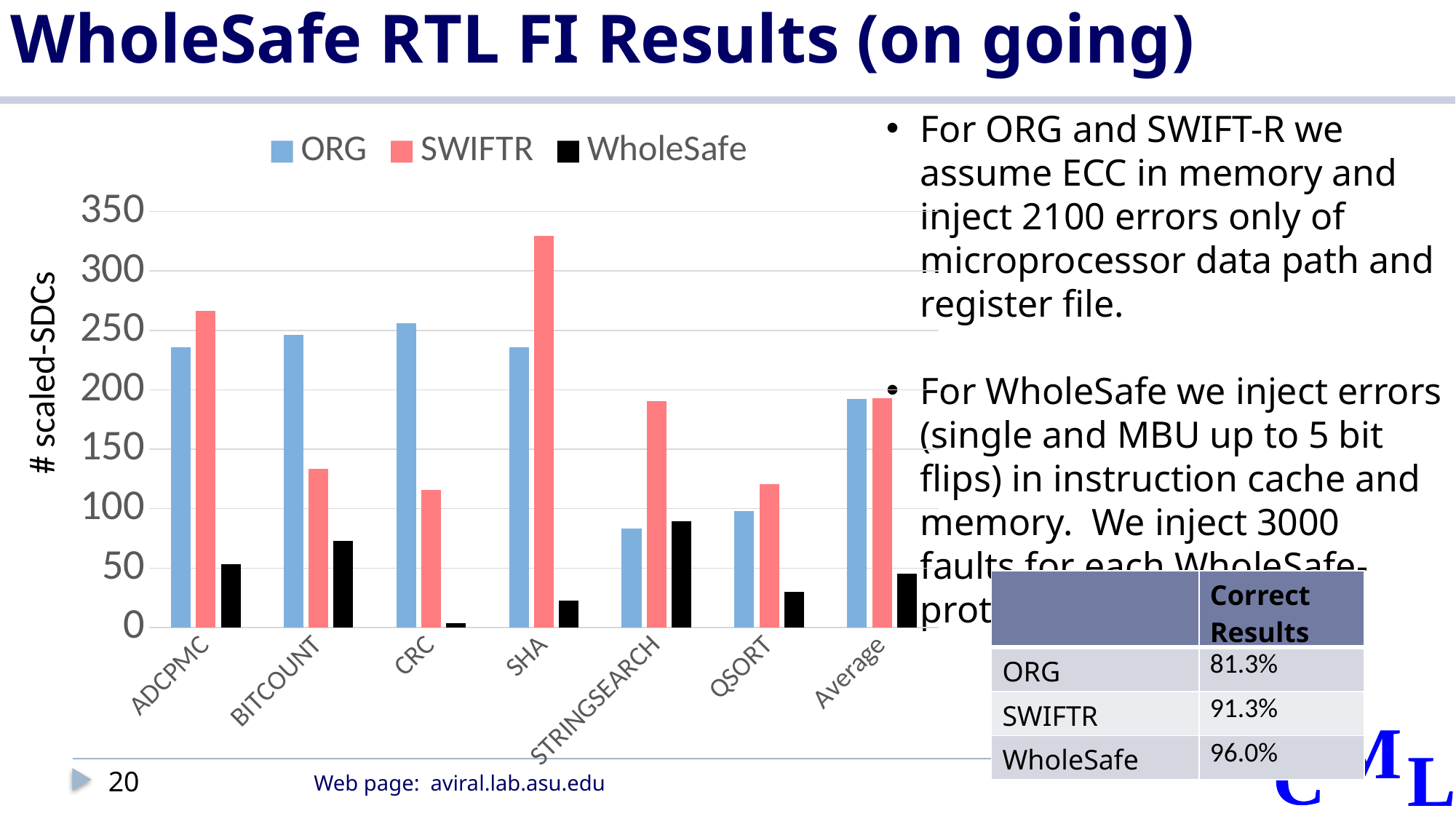
Is the ORG value for STRINGSEARCH greater or less than 100? less Is the SWIFTR value for STRINGSEARCH greater or less than 150? greater How many categories are shown along the x axis of the chart? 7 For BITCOUNT, which is larger: the ORG bar or the SWIFTR bar? ORG Is the SWIFTR value for SHA greater or less than 300? greater What is the label on the y axis of the chart? # scaled-SDCs What kind of chart is shown on the slide? bar chart For which category is the WholeSafe bar the lowest? CRC For which category is the SWIFTR bar the highest? SHA How many series does the chart legend list? 3 For ADCPMC, which is larger: the ORG bar or the SWIFTR bar? SWIFTR